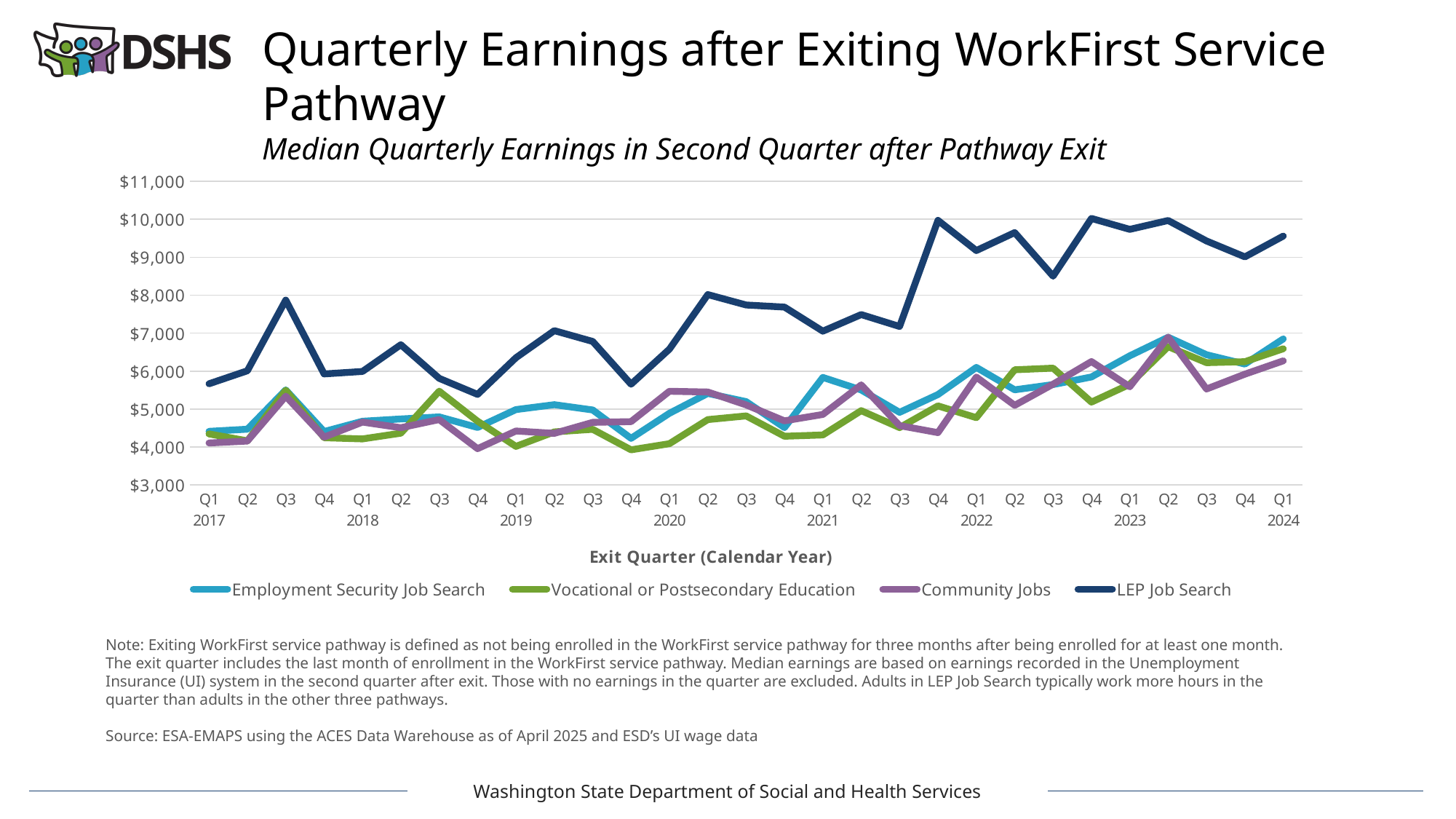
Overall, do the median earnings for LEP Job Search rise or fall from Q1 2017 to Q1 2024? Rise How many series does the legend list? 4 What is the title of the x axis? Exit Quarter (Calendar Year) Is the value for Employment Security Job Search in Q1 2024 greater or less than $6,000? greater Is the value for LEP Job Search in Q1 2017 greater or less than $5,000? greater Which series has the lowest median earnings in Q4 2019? Vocational or Postsecondary Education Which series has the highest median earnings in Q4 2021? LEP Job Search How many exit quarters are plotted along the x axis? 29 In Q3 2018, which is larger: Vocational or Postsecondary Education or Community Jobs? Vocational or Postsecondary Education Is the value for LEP Job Search in Q3 2022 greater or less than $8,000? greater In Q1 2021, which is larger: Employment Security Job Search or Vocational or Postsecondary Education? Employment Security Job Search What kind of chart is shown on the slide? Line chart